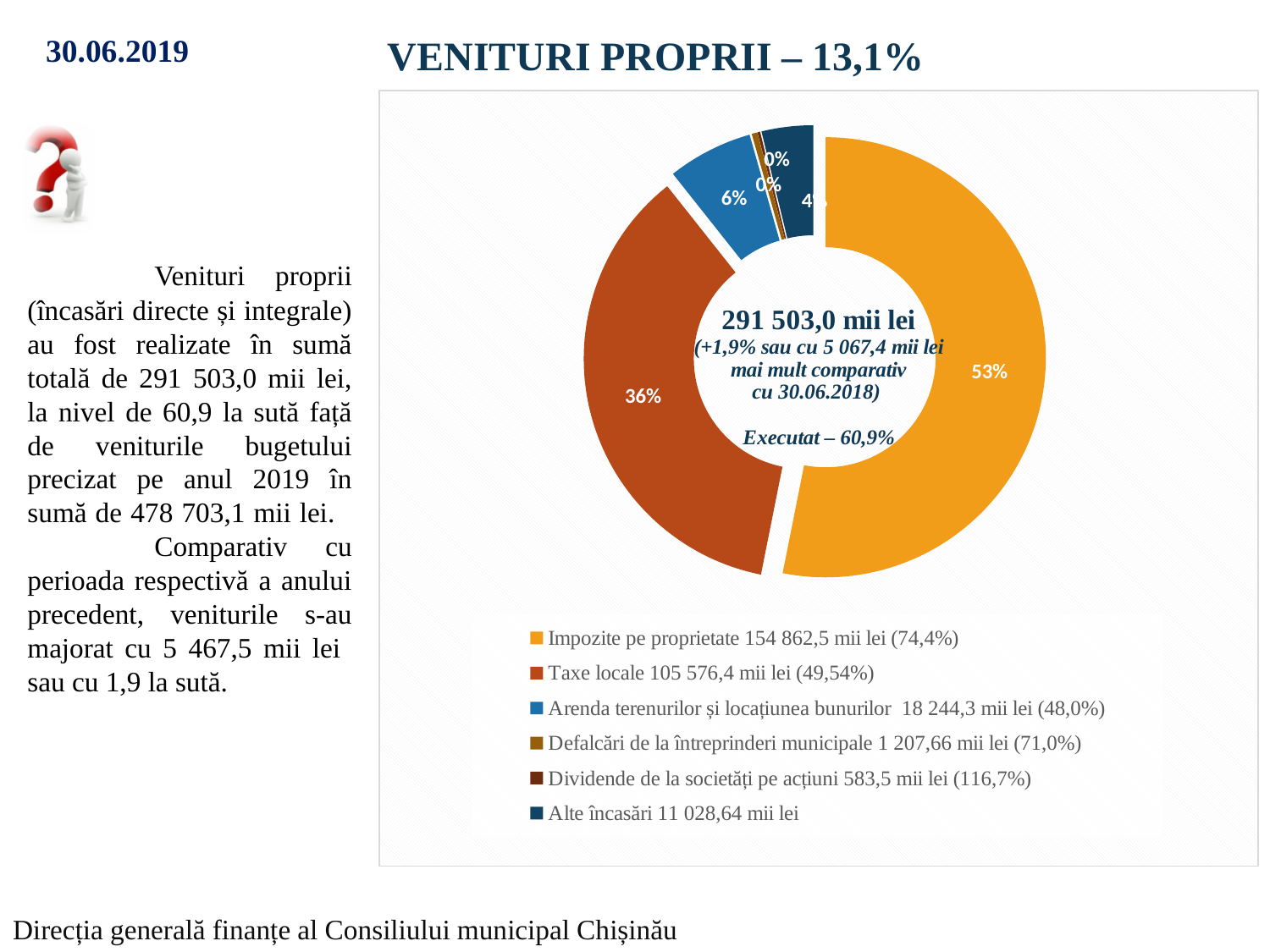
How many categories does the legend of the doughnut chart list? 6 Which category has the largest slice in the doughnut chart? Impozite pe proprietate What total amount is printed in the centre of the doughnut chart? 291 503,0 mii lei What share of the doughnut chart does Arenda terenurilor și locațiunea bunurilor represent? 6% According to the legend, what amount is shown for Dividende de la societăți pe acțiuni? 583,5 mii lei Which slice is larger in the doughnut chart: Taxe locale or Arenda terenurilor și locațiunea bunurilor? Taxe locale What share of the doughnut chart does Taxe locale represent? 36% What kind of chart is shown on the slide? doughnut (pie) chart According to the legend, what amount is shown for Taxe locale? 105 576,4 mii lei What share of the doughnut chart does Impozite pe proprietate represent? 53% What is the difference in percentage points between the Impozite pe proprietate slice and the Taxe locale slice? 17 percentage points According to the legend, what amount is shown for Alte încasări? 11 028,64 mii lei